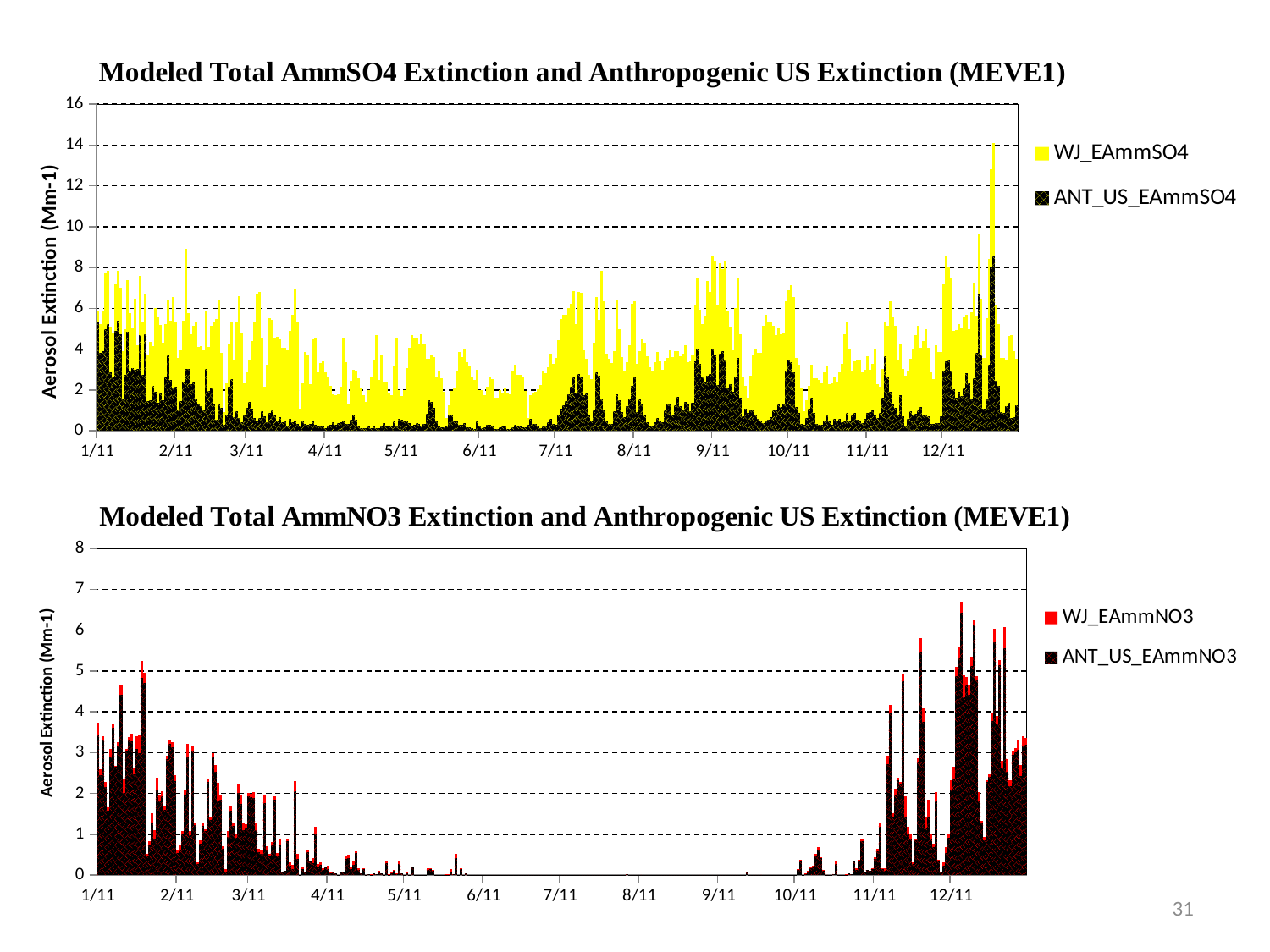
In the bottom chart (Modeled Total AmmNO3 Extinction), are the values around 7/11 greater or less than 1? less What kind of chart is the top chart (Modeled Total AmmSO4 Extinction)? bar chart In the top chart (Modeled Total AmmSO4 Extinction), is the highest peak of WJ_EAmmSO4 greater or less than 12? greater In the bottom chart (Modeled Total AmmNO3 Extinction), how many series does the legend list? 2 In the bottom chart (Modeled Total AmmNO3 Extinction), what colour represents the WJ_EAmmNO3 series? red In the top chart (Modeled Total AmmSO4 Extinction), what is the highest value shown on the y axis? 16 In the bottom chart (Modeled Total AmmNO3 Extinction), is the highest peak of WJ_EAmmNO3 greater or less than 6? greater In the bottom chart (Modeled Total AmmNO3 Extinction), which period has higher values, 7/11 or 12/11? 12/11 How many month labels are shown along the x axis of the bottom chart (Modeled Total AmmNO3 Extinction)? 12 In the top chart (Modeled Total AmmSO4 Extinction), which series generally has the larger values, WJ_EAmmSO4 or ANT_US_EAmmSO4? WJ_EAmmSO4 In the top chart (Modeled Total AmmSO4 Extinction), how many series does the legend list? 2 In the bottom chart (Modeled Total AmmNO3 Extinction), do the values generally rise or fall from 1/11 to 6/11? fall